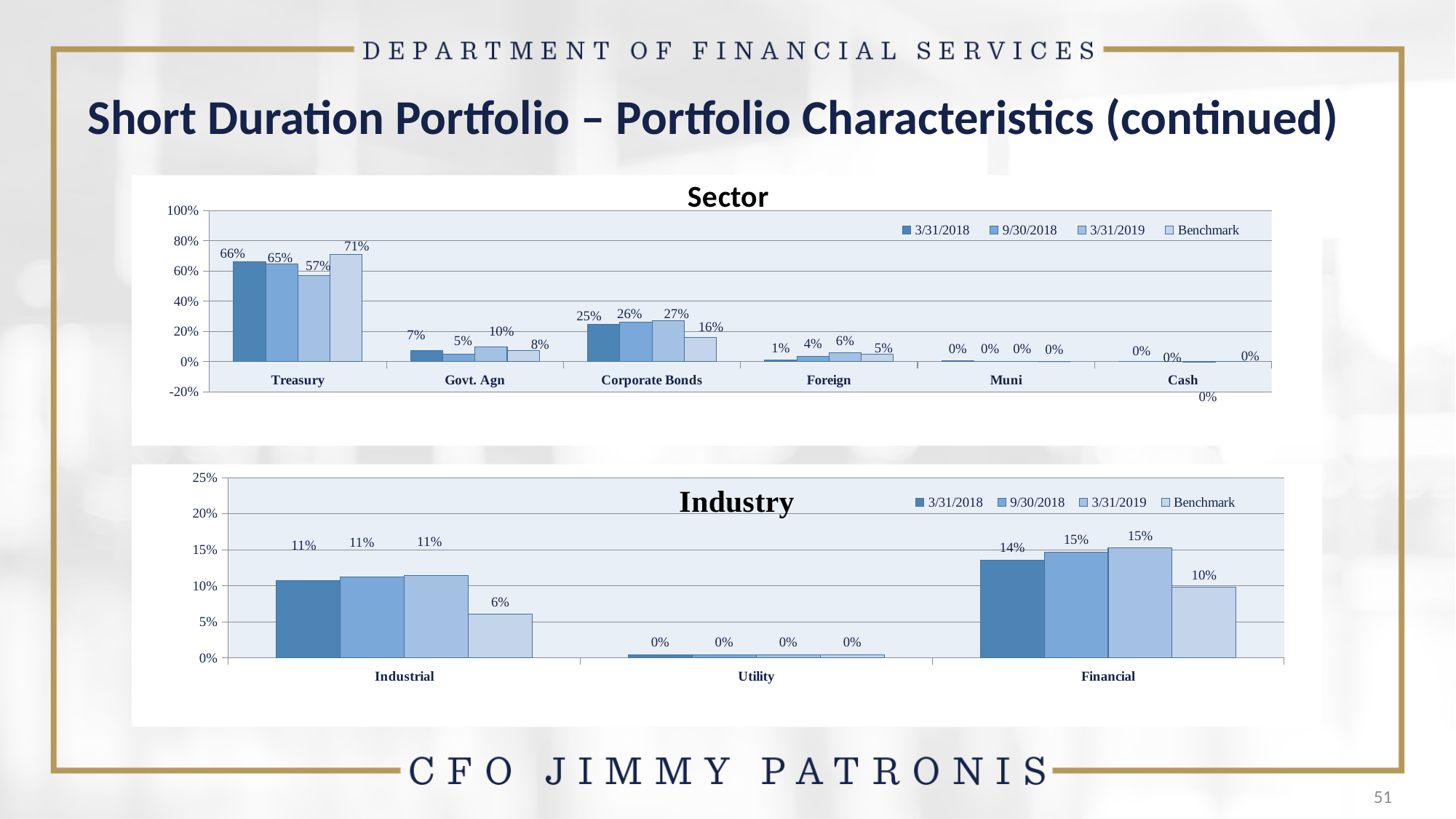
In the Industry chart, what is the difference between the Financial and Industrial values for the Benchmark series? 4% What kind of chart is the Industry chart? Bar chart In the Sector chart, which is larger for Govt. Agn: the 3/31/2019 value or the Benchmark value? 3/31/2019 How many categories are shown on the x axis of the Sector chart? 6 In the Sector chart, what is the difference between the Treasury values for 3/31/2018 and 3/31/2019? 9% In the Sector chart, what is the Corporate Bonds value for 3/31/2019? 27% In the Sector chart, which category has the highest value for 3/31/2018? Treasury In the Sector chart, what is the Foreign value for 9/30/2018? 4% In the Industry chart, which category has the lowest values across all series? Utility How many series does the legend of the Industry chart list? 4 In the Sector chart, what is the Treasury value for the Benchmark series? 71% In the Industry chart, what is the Financial value for 3/31/2018? 14%